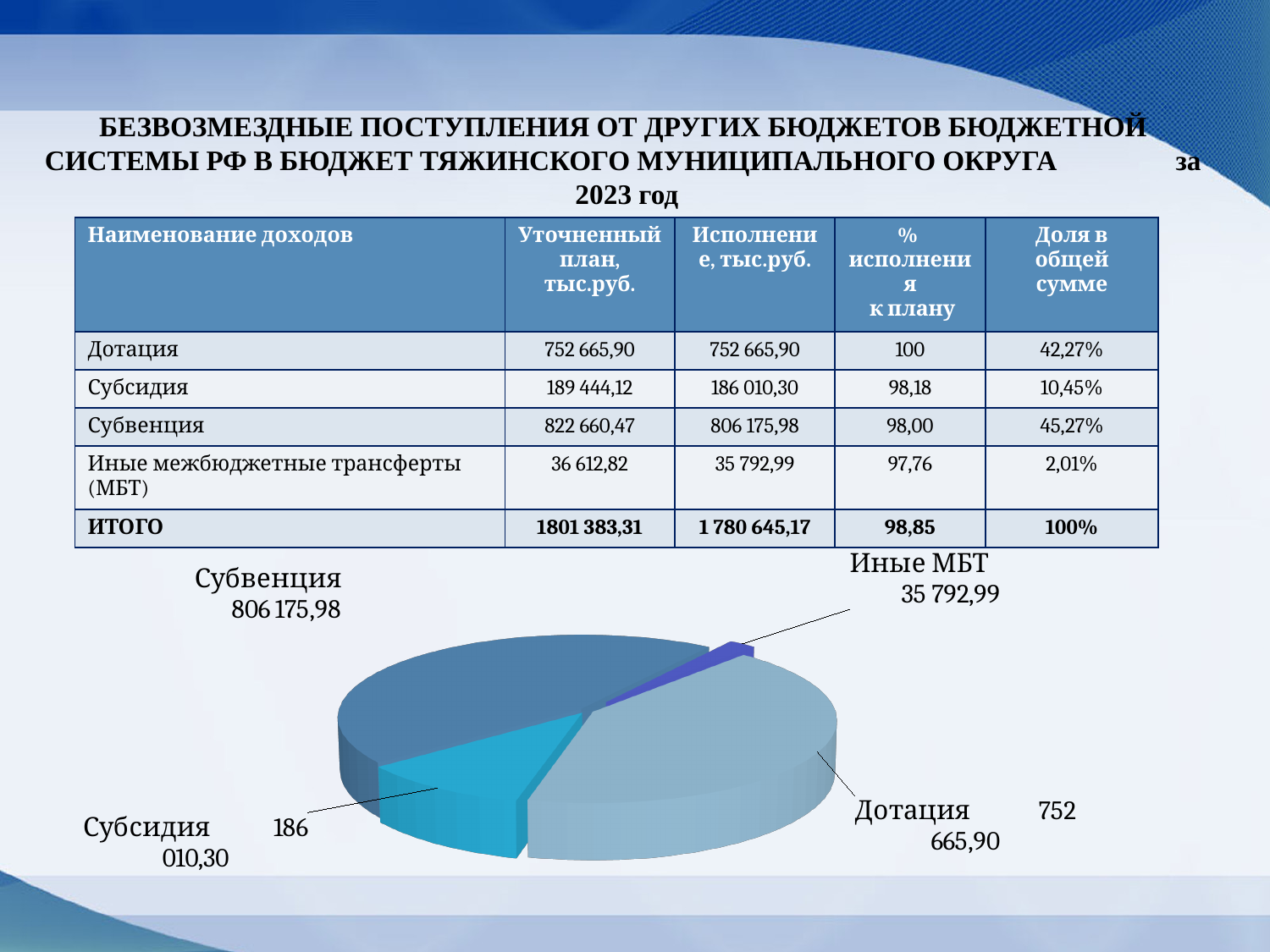
According to the slide, what share of the total does the Субвенция slice represent? 45,27% What is the value shown for Дотация in the pie chart? 752 665,90 What kind of chart is shown on the slide? pie chart Which slice of the pie chart is the largest? Субвенция In the pie chart, which is larger: Субсидия or Дотация? Дотация What is the value shown for Иные МБТ in the pie chart? 35 792,99 What is the value shown for Субвенция in the pie chart? 806 175,98 What is the difference between the Субвенция and Дотация values in the pie chart? 53 510,08 What is the total of all four values shown in the pie chart? 1 780 645,17 What is the value shown for Субсидия in the pie chart? 186 010,30 How many slices does the pie chart have? 4 Which slice of the pie chart is the smallest? Иные МБТ